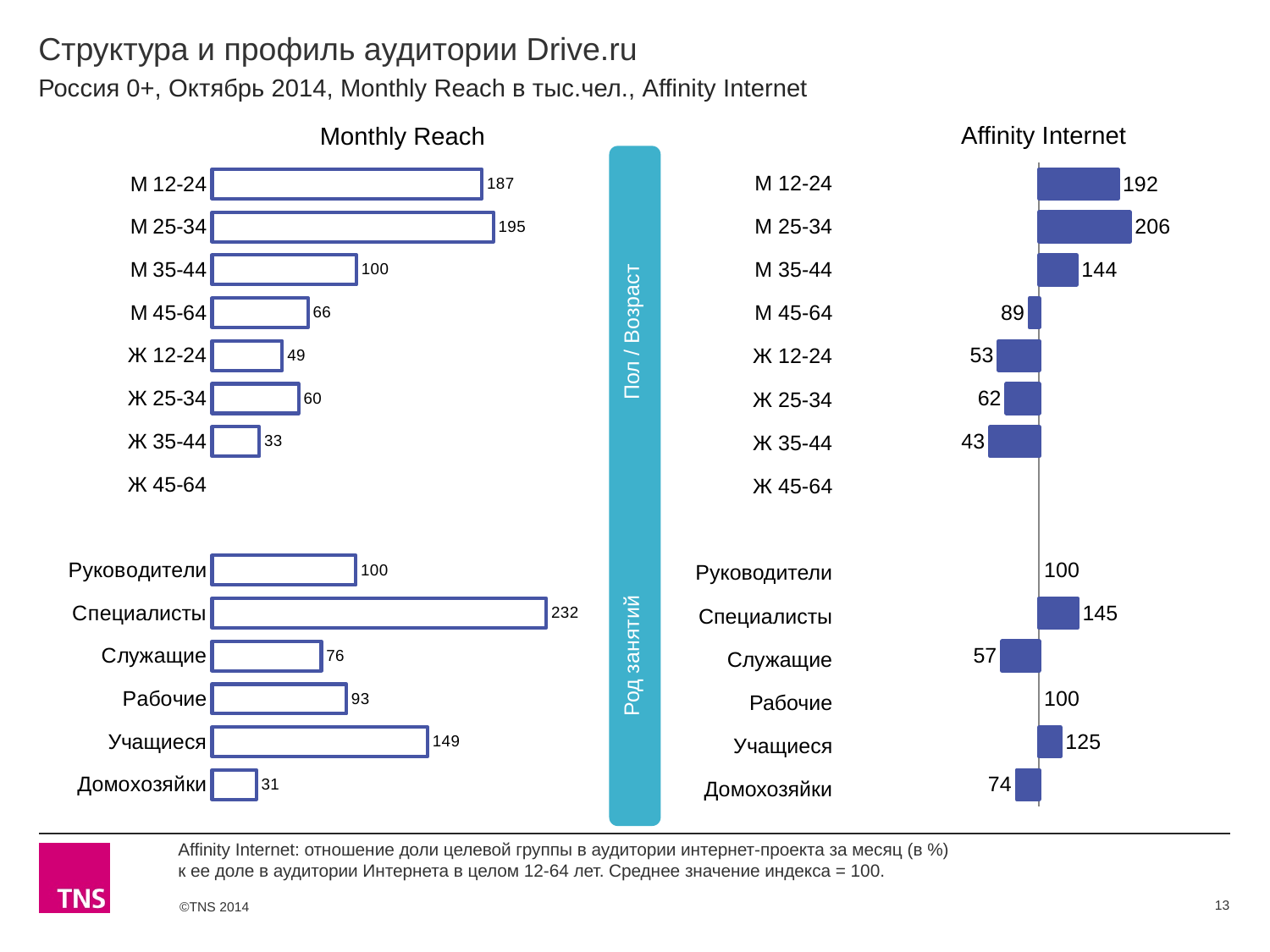
On the Monthly Reach chart, which category among the labelled bars has the lowest value? Домохозяйки On the Monthly Reach chart, what is the difference between М 25-34 and М 12-24? 8 On the Monthly Reach chart, what is the value for Специалисты? 232 On the Monthly Reach chart, which is larger: Учащиеся or Рабочие? Учащиеся On the Affinity Internet chart, which category among the labelled bars has the lowest value? Ж 35-44 On the Affinity Internet chart, which category has the highest value? М 25-34 On the Monthly Reach chart, which category has the highest value? Специалисты On the Affinity Internet chart, what is the value for Домохозяйки? 74 What type of chart is the Monthly Reach chart? Bar chart On the Affinity Internet chart, what is the difference between Специалисты and Служащие? 88 On the Affinity Internet chart, what is the value for М 25-34? 206 On the Monthly Reach chart, what is the value for М 25-34? 195